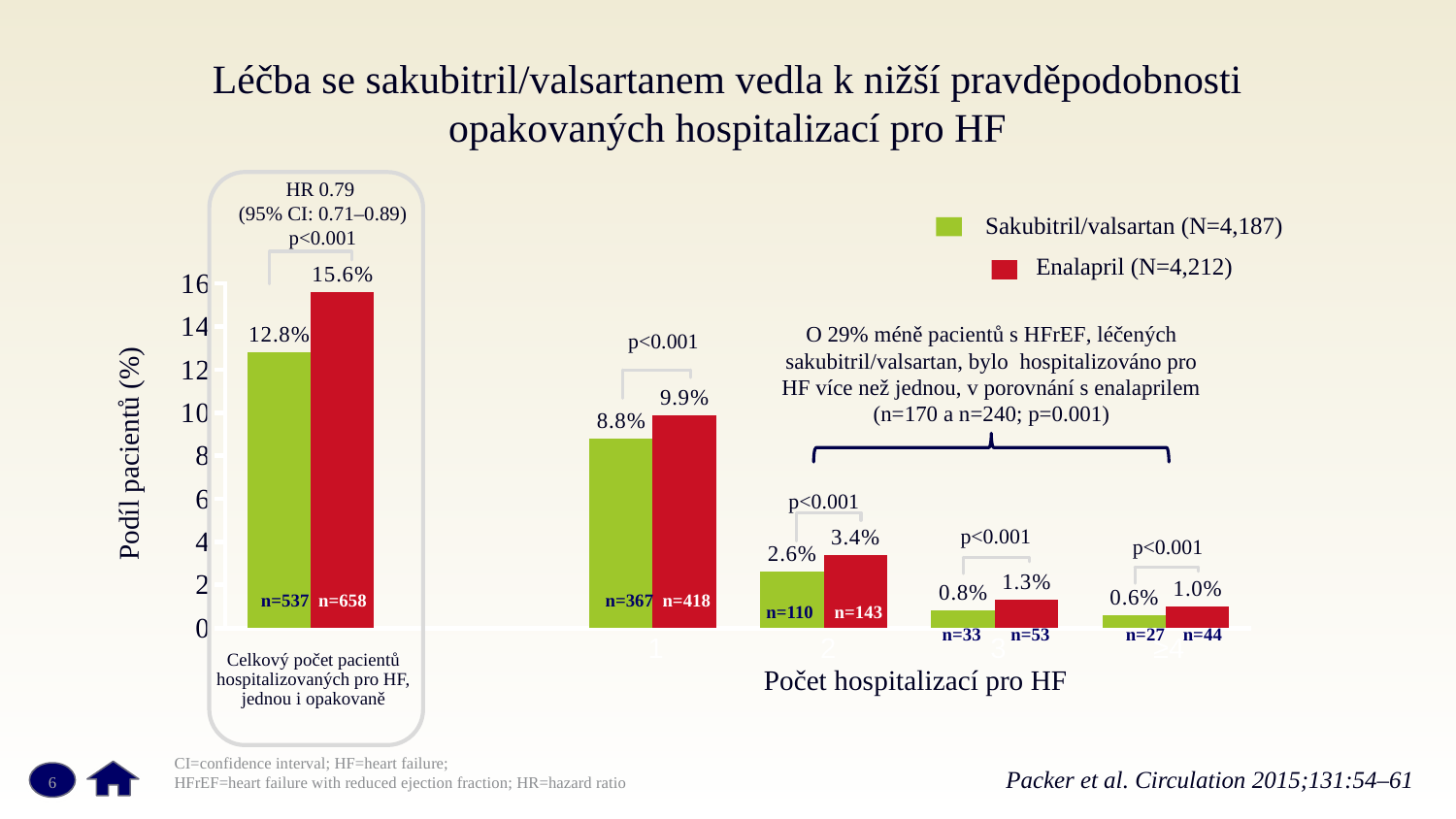
What is the value for Enalapril in the 'Celkový počet pacientů hospitalizovaných pro HF, jednou i opakovaně' group? 15.6% What is the lowest value shown on the chart? 0.6% In the 'Celkový počet pacientů hospitalizovaných pro HF' group, how much higher is the Enalapril value than the Sakubitril/valsartan value? 2.8 percentage points Moving from left to right across the 'Počet hospitalizací pro HF' groups, do the values rise or fall? Fall According to the legend, what is the N for Sakubitril/valsartan? N=4,187 What is the label of the y axis? Podíl pacientů (%) What is the value for Sakubitril/valsartan in the 'Celkový počet pacientů hospitalizovaných pro HF, jednou i opakovaně' group? 12.8% What is the n value printed on the Enalapril bar in the 'Celkový počet pacientů hospitalizovaných pro HF' group? n=658 What kind of chart is shown on the slide? Bar chart How many series does the legend list? 2 Which bar has the highest value on the chart? Enalapril in the 'Celkový počet pacientů hospitalizovaných pro HF' group (15.6%) In the group labelled n=367 and n=418, which series has the larger value? Enalapril (9.9%)